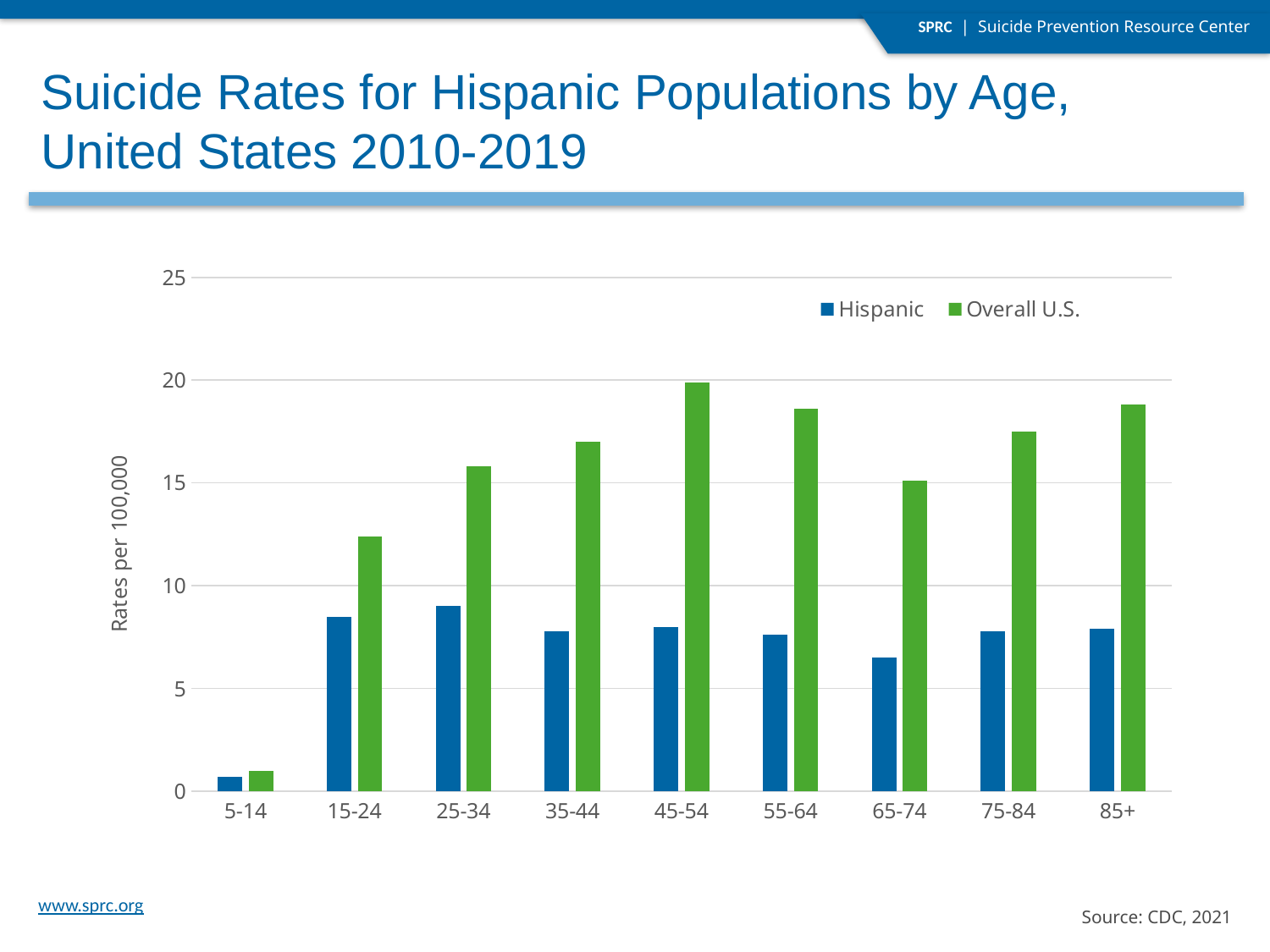
Is the Overall U.S. value for the 45-54 age group greater or less than 15? greater What kind of chart is shown on the slide? Bar chart Which age group has the highest Overall U.S. suicide rate? 45-54 Is the Overall U.S. value for the 5-14 age group greater or less than 5? less How many series does the legend list? 2 Is the Hispanic value for the 25-34 age group greater or less than 10? less Which age group has the lowest Hispanic suicide rate? 5-14 What is the label of the y axis? Rates per 100,000 How many age groups are shown on the x axis? 9 Which is larger, the Overall U.S. value for 55-64 or for 65-74? 55-64 Which age group has the highest Hispanic suicide rate? 25-34